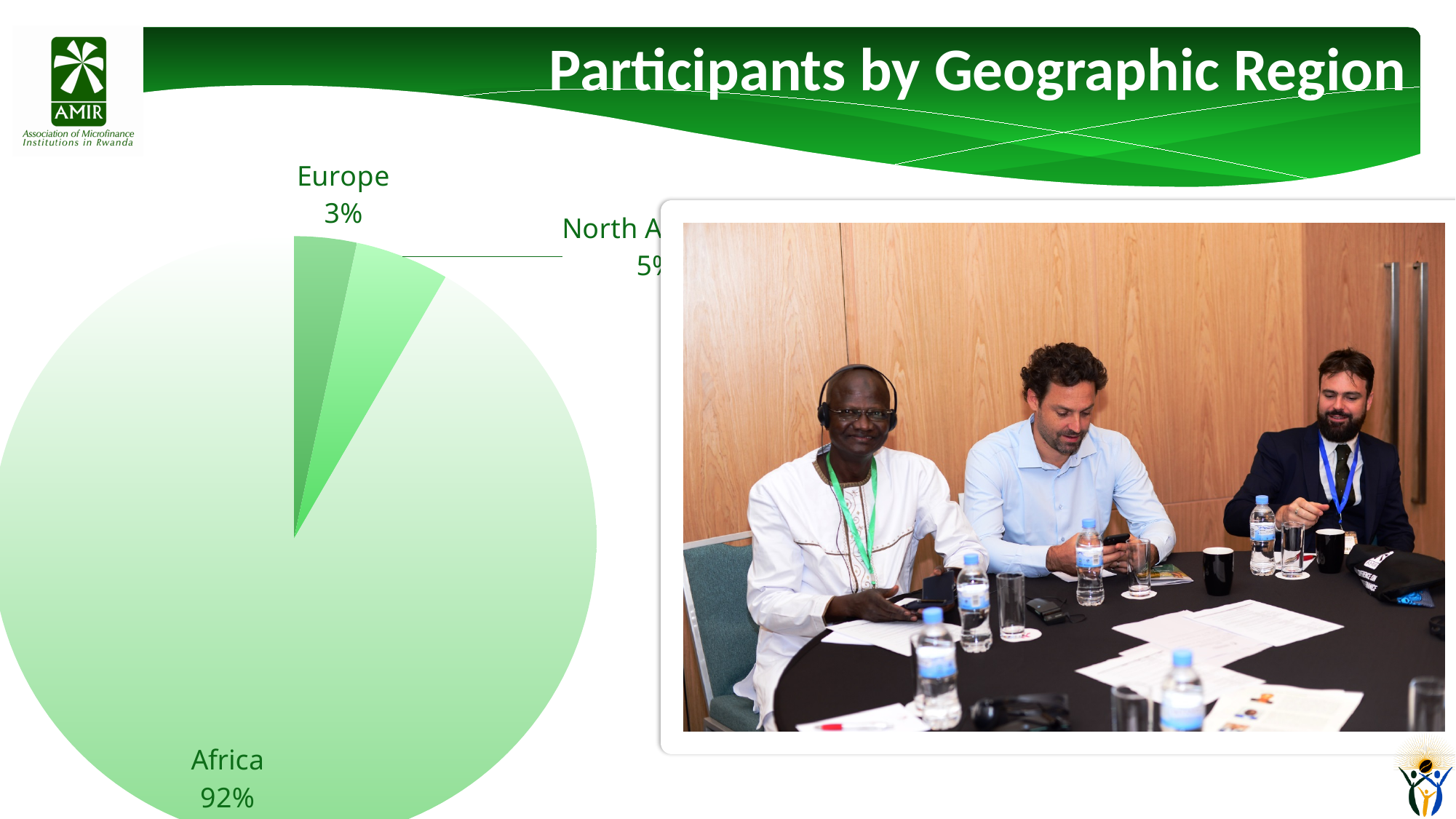
Which region has the largest share of participants? Africa Which has a larger share of participants, Africa or Europe? Africa What is the difference in percentage points between the Africa share and the Europe share? 89 percentage points What share of the pie does the Africa slice represent? 92% What percentage of participants are from Europe? 3% How many slices does the pie chart have? 3 What is the title of the chart on the slide? Participants by Geographic Region What percentage of participants are from Africa? 92% Which region has the smallest share of participants? Europe What kind of chart is shown on the slide? Pie chart